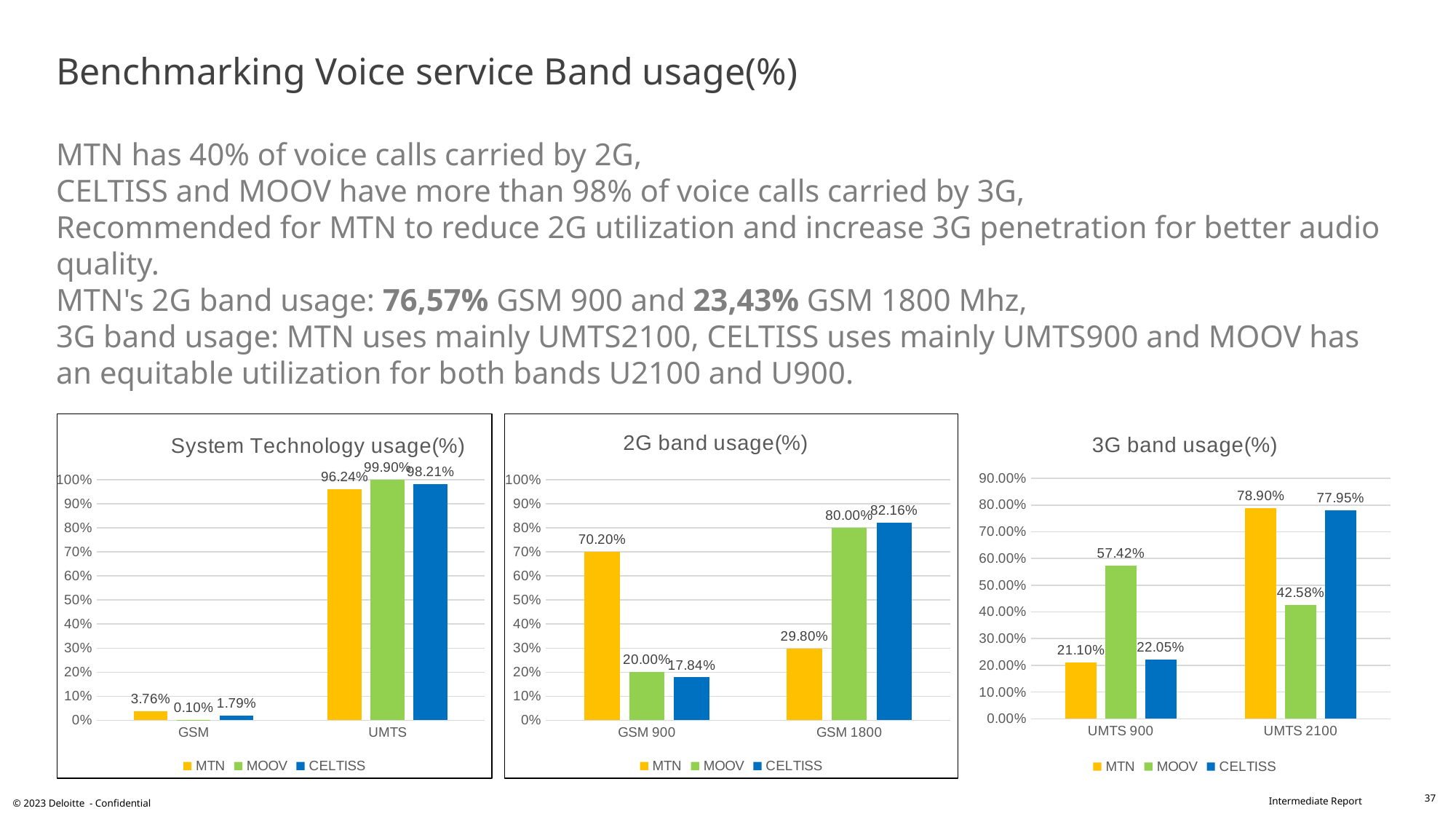
In the '2G band usage(%)' chart, which series has the lowest value at GSM 900? CELTISS In the 'System Technology usage(%)' chart, what is the value for MTN at GSM? 3.76% In the '3G band usage(%)' chart, what is the difference between MTN at UMTS 2100 and MTN at UMTS 900? 57.80% How many series does the legend of the '2G band usage(%)' chart list? 3 In the '3G band usage(%)' chart, which is larger at UMTS 2100: MTN or MOOV? MTN In the '2G band usage(%)' chart, what is the difference between CELTISS and MOOV at GSM 1800? 2.16% How many categories are shown on the x axis of the 'System Technology usage(%)' chart? 2 In the 'System Technology usage(%)' chart, what is the value for CELTISS at UMTS? 98.21% In the '2G band usage(%)' chart, what is the value for MTN at GSM 900? 70.20% In the 'System Technology usage(%)' chart, which series has the highest value at UMTS? MOOV In the '3G band usage(%)' chart, what is the value for MOOV at UMTS 900? 57.42% What kind of chart is the '3G band usage(%)' chart? Bar chart